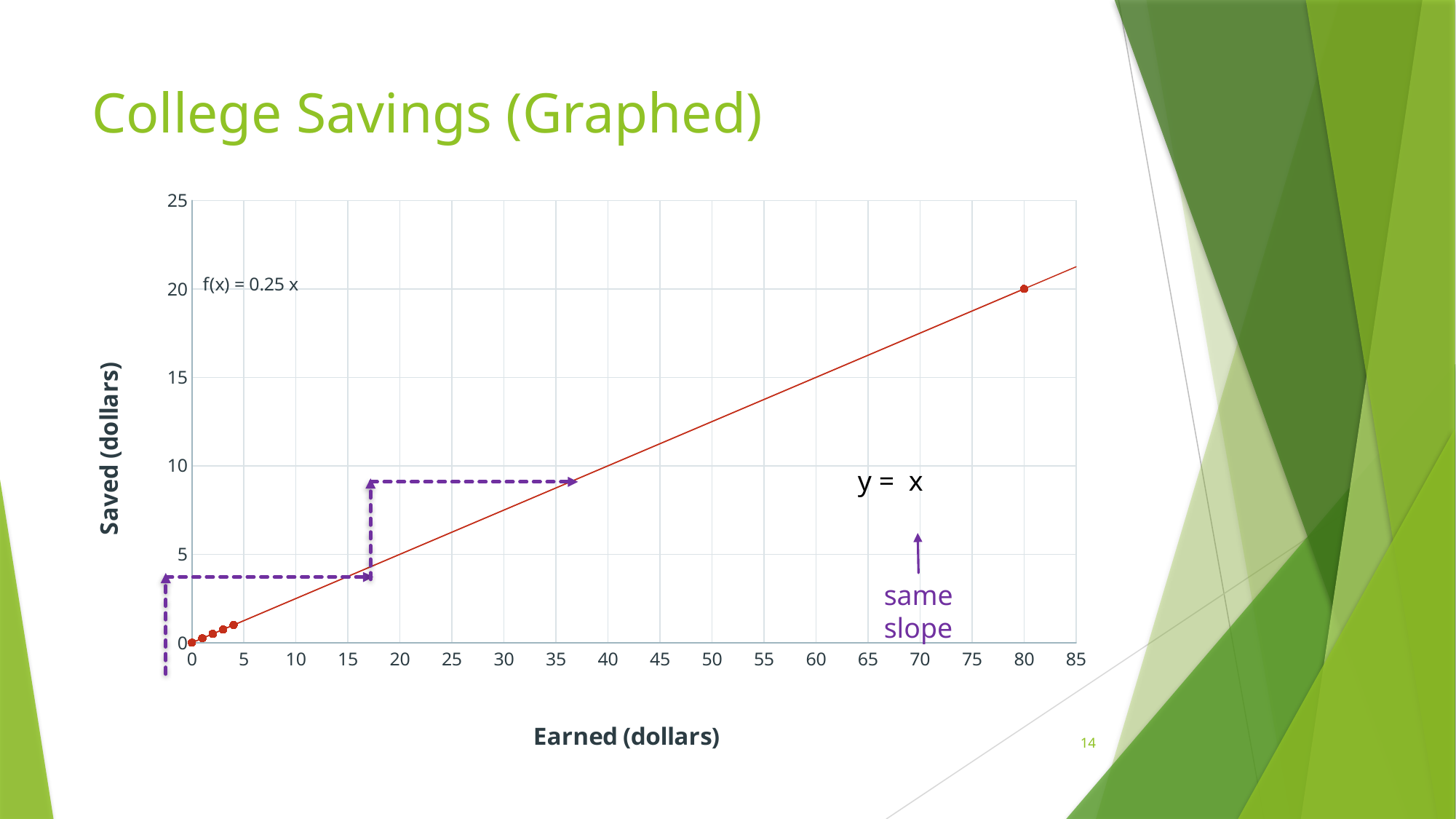
What is the title of the chart on the slide? College Savings (Graphed) At which earned amount is the plotted saved value highest? 80 How many dollars are saved when 0 dollars are earned? 0 Is the saved value at 40 dollars earned greater or less than 15? less What kind of chart is shown on the slide? scatter chart What function is written on the chart? f(x) = 0.25 x Is the saved value at 60 dollars earned greater or less than 10? greater How many dollars are saved when 80 dollars are earned? 20 How many data points are plotted on the chart? 6 Is the saved value at 20 dollars earned greater or less than 10? less Do the saved values rise or fall as earned dollars increase? rise What is the label of the horizontal axis? Earned (dollars)